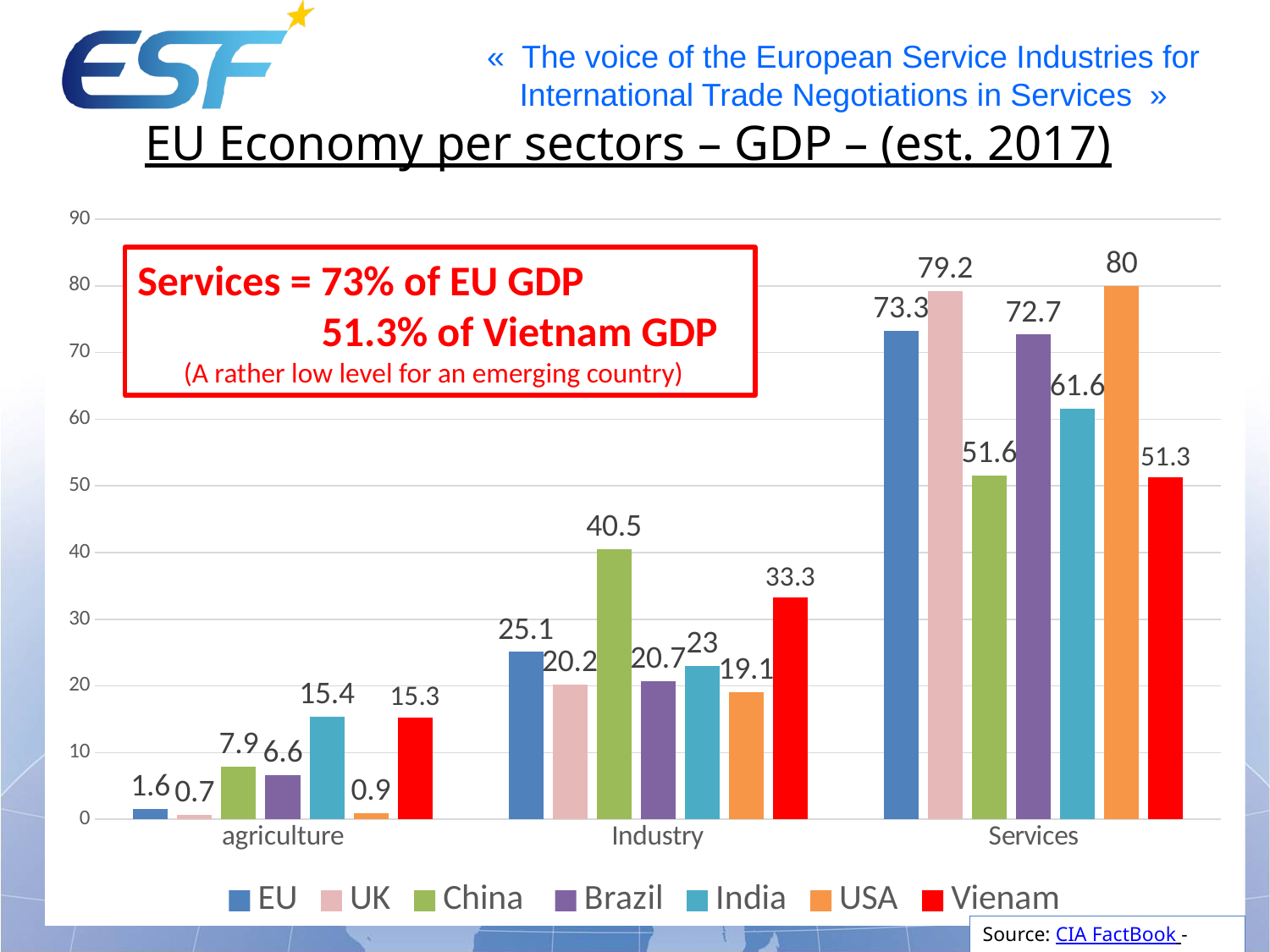
What is the difference between the UK and Vienam values in the Services category? 27.9 What kind of chart is shown on the slide? Bar chart What is the value for the USA in the Services category? 80 What is the value for India in the agriculture category? 15.4 Which series has the highest value in the Industry category? China What is the title of the chart? EU Economy per sectors – GDP – (est. 2017) Which is larger in the Industry category, the value for Vienam or the value for the EU? Vienam How many series does the legend list? 7 Which series has the lowest value in the agriculture category? UK What is the value for China in the Industry category? 40.5 What is the value for the EU in the Services category? 73.3 How many categories are shown on the x axis? 3